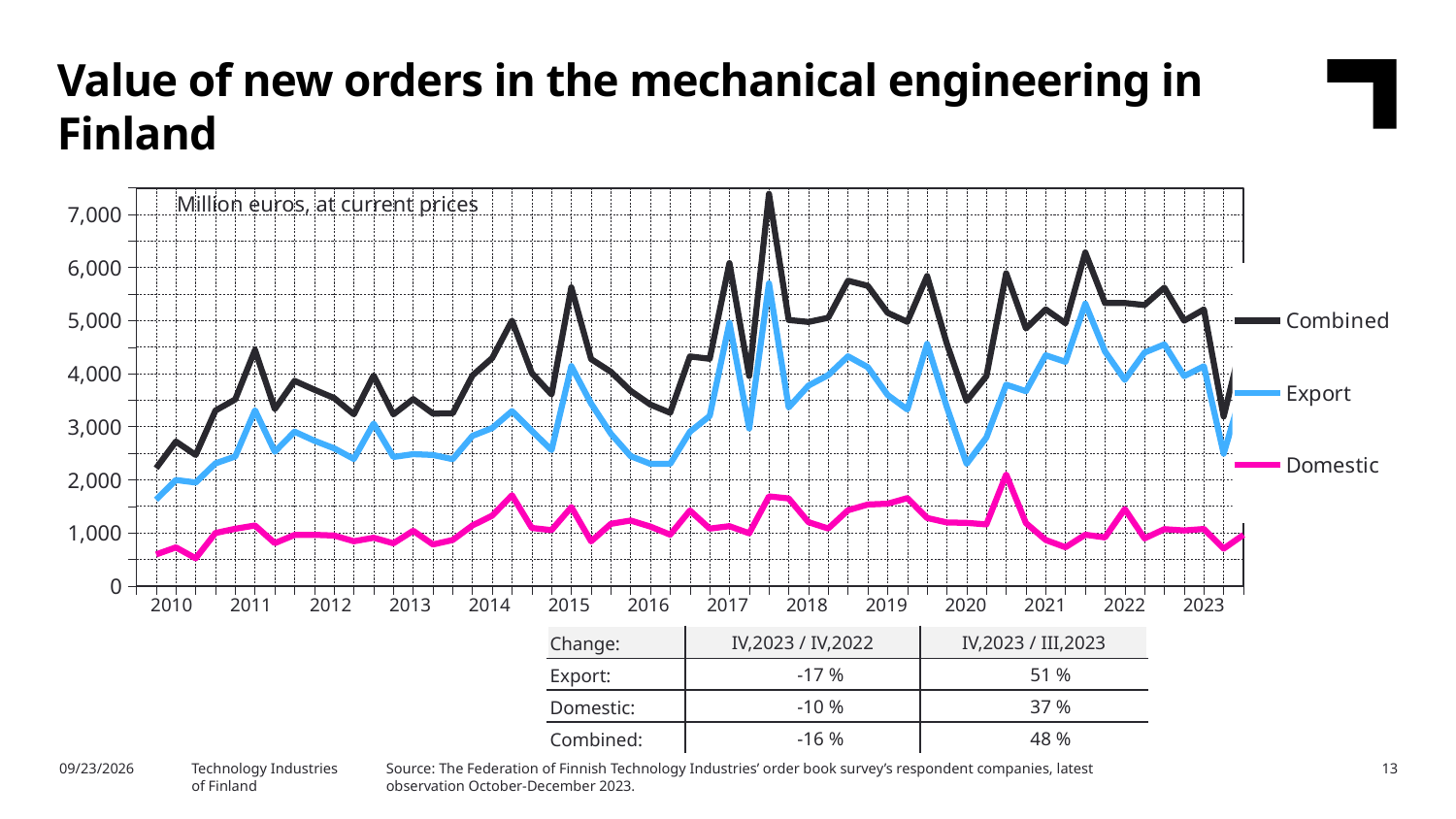
How many year labels are shown on the x axis? 14 Is the first Export value in 2010 greater or less than 2,000? less Is the highest value of the Domestic series greater or less than 3,000? less What unit is stated in the chart's subtitle? Million euros, at current prices Is the peak value of the Combined series in 2017 greater or less than 7,000? greater Which series has the lowest values throughout the chart? Domestic Which series has the highest values throughout the chart? Combined How many series does the legend list? 3 What kind of chart is shown on the slide? Line chart Which is larger in 2017, the Export series or the Domestic series? Export Does the Combined series rise or fall from the start of 2010 to the start of 2011? Rise